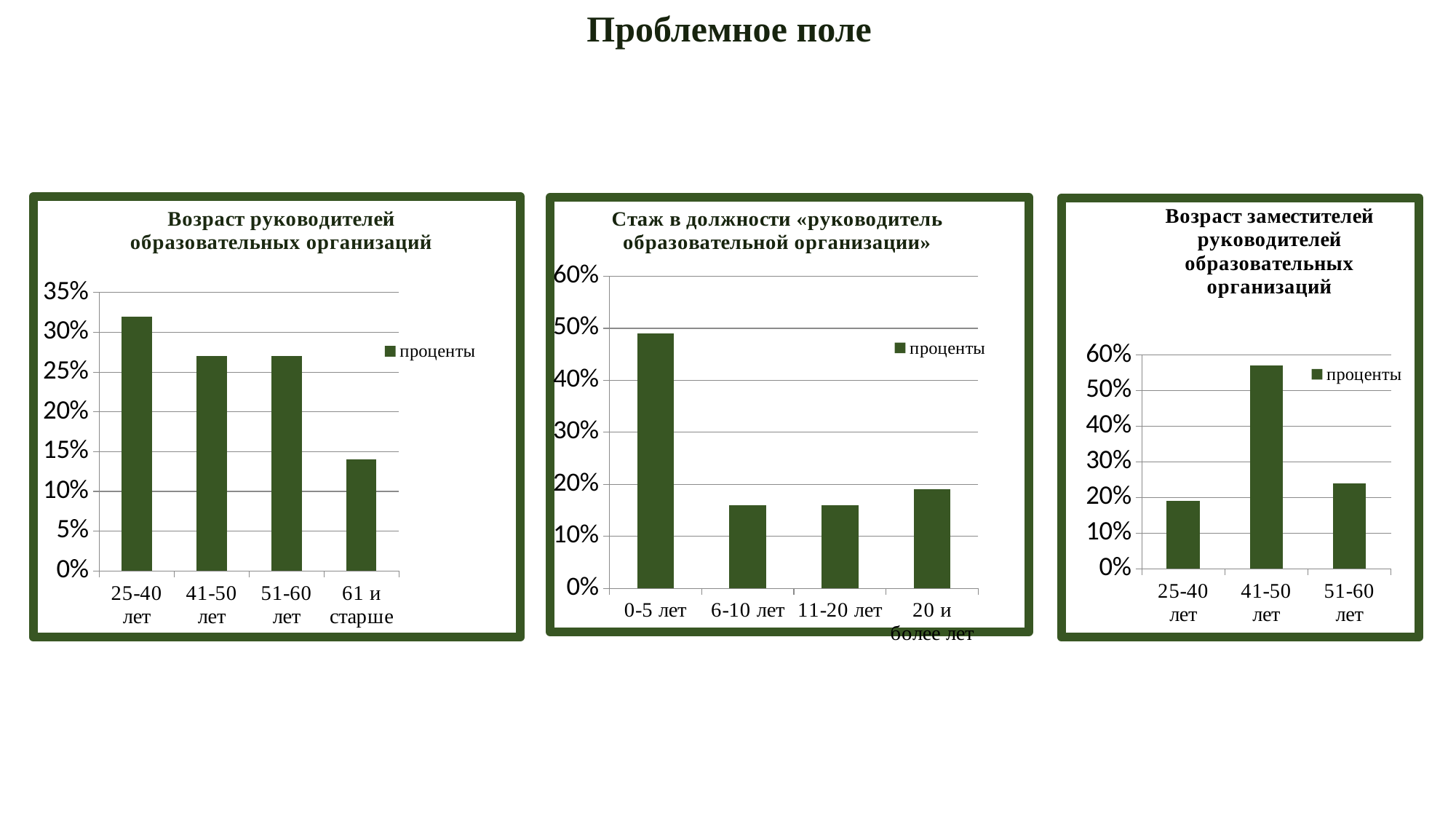
On the chart titled "Возраст руководителей образовательных организаций", how many age categories are shown? 4 On the chart titled "Возраст заместителей руководителей образовательных организаций", which age group has the highest value? 41-50 лет On the chart titled "Возраст руководителей образовательных организаций", which age group has the highest value? 25-40 лет On the chart titled "Стаж в должности «руководитель образовательной организации»", which category has the highest value? 0-5 лет On the chart titled "Стаж в должности «руководитель образовательной организации»", is the value for 0-5 лет greater or less than 40%? greater What type of chart is the chart titled "Возраст заместителей руководителей образовательных организаций"? bar chart On the chart titled "Стаж в должности «руководитель образовательной организации»", which is larger: the value for 0-5 лет or the value for 20 и более лет? 0-5 лет On the chart titled "Возраст руководителей образовательных организаций", is the value for 25-40 лет greater or less than 30%? greater On the chart titled "Возраст заместителей руководителей образовательных организаций", is the value for 41-50 лет greater or less than 50%? greater On the chart titled "Возраст руководителей образовательных организаций", which age group has the lowest value? 61 и старше